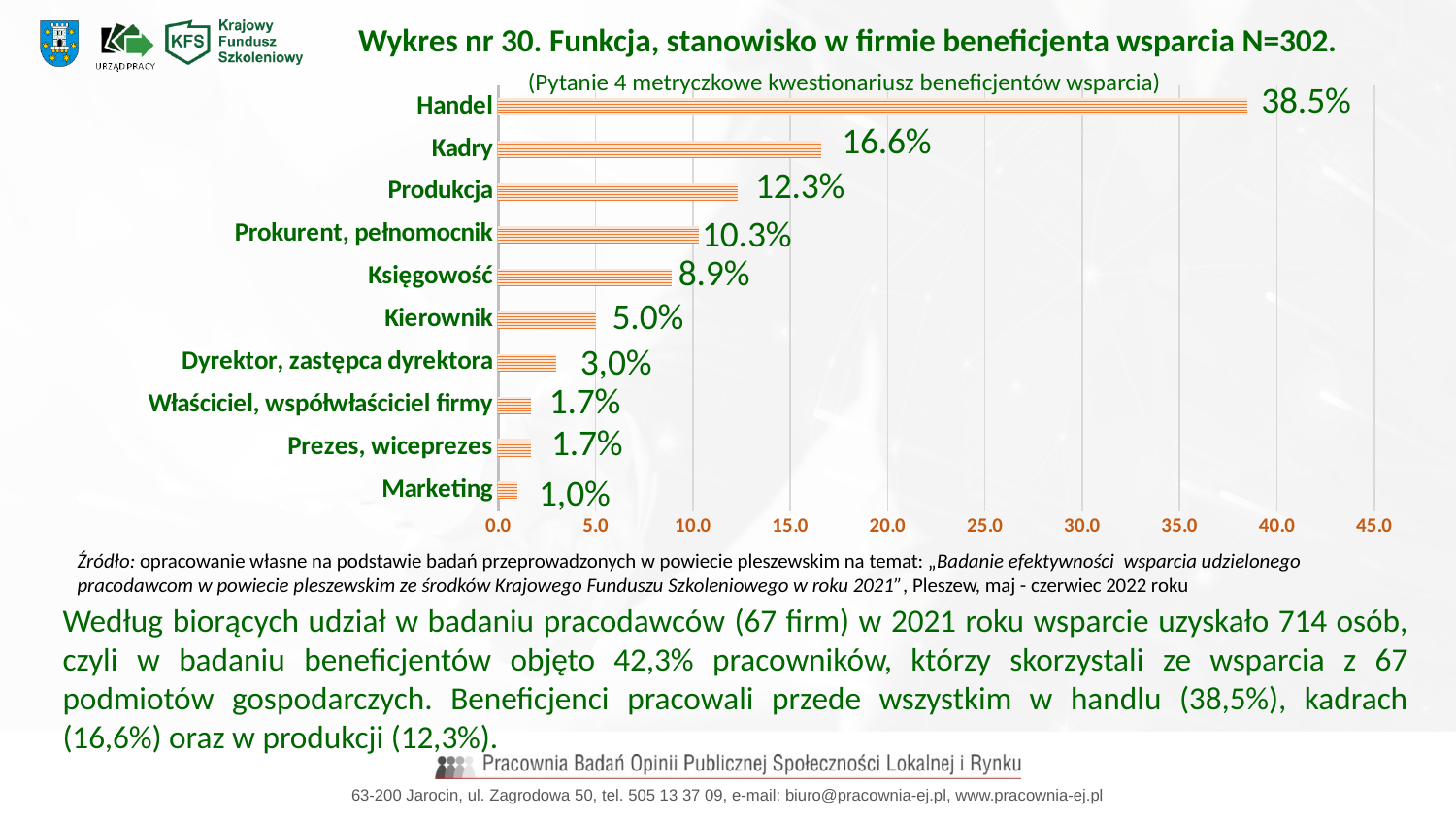
What kind of chart is shown on the slide? bar chart How many categories are shown in the chart? 10 What is the value for Kadry? 16.6% Which category has the highest value? Handel Is the value for Handel greater or less than 35.0? greater Which is larger, the value for Produkcja or the value for Prokurent, pełnomocnik? Produkcja What is the value for Marketing? 1,0% What is the value for Handel? 38.5% What is the value for Księgowość? 8.9% Which category has the lowest value? Marketing What is the difference between the values for Handel and Kadry? 21.9 percentage points What is the title of the chart? Wykres nr 30. Funkcja, stanowisko w firmie beneficjenta wsparcia N=302.